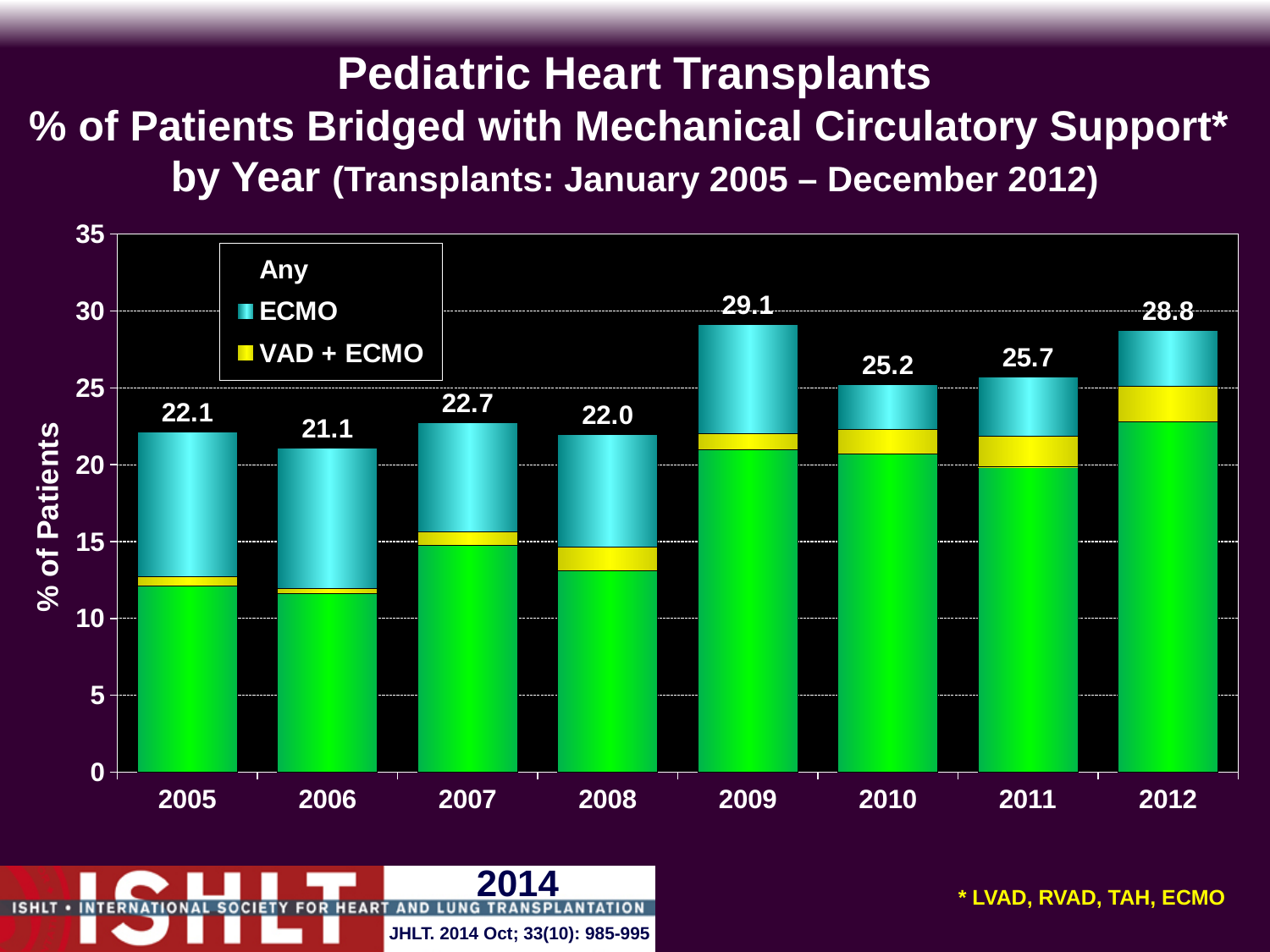
Which year has the highest total percentage of patients bridged with mechanical circulatory support? 2009 How many years are shown on the x axis? 8 What is the label of the y axis? % of Patients Is the green (Any) segment for 2012 greater or less than 20? greater Which year has a larger total value, 2010 or 2011? 2011 How many series does the legend list? 3 What is the total value shown for 2012? 28.8 What is the total percentage of patients bridged with mechanical circulatory support in 2009? 29.1 What is the difference between the total values for 2009 and 2005? 7.0 What is the total value shown for 2006? 21.1 What kind of chart is shown on the slide? Stacked bar chart Which year has the lowest total percentage of patients bridged with mechanical circulatory support? 2006